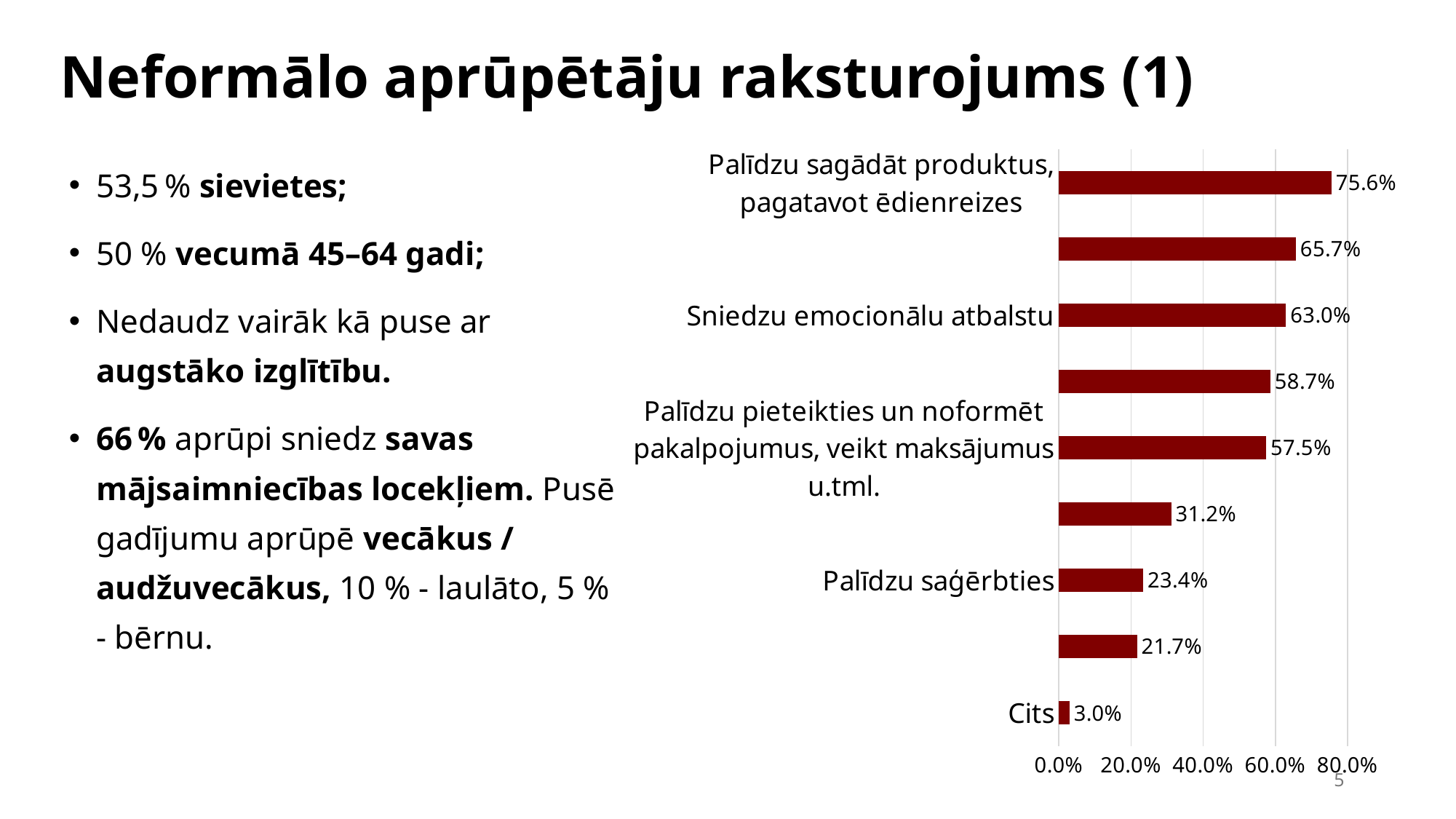
What is the value for "Palīdzu saģērbties"? 23.4% What is the value for "Palīdzu pieteikties un noformēt pakalpojumus, veikt maksājumus u.tml."? 57.5% Which category has the lowest value? Cits What is the difference between the values for "Sniedzu emocionālu atbalstu" and "Palīdzu saģērbties"? 39.6% What kind of chart is shown on the slide? bar chart Which is larger: the value for "Sniedzu emocionālu atbalstu" or the value for "Palīdzu pieteikties un noformēt pakalpojumus, veikt maksājumus u.tml."? Sniedzu emocionālu atbalstu What is the value for "Palīdzu sagādāt produktus, pagatavot ēdienreizes"? 75.6% What is the value for "Cits"? 3.0% How many bars are plotted in the chart? 9 Which category has the highest value? Palīdzu sagādāt produktus, pagatavot ēdienreizes Is the value for "Palīdzu saģērbties" greater or less than 40.0%? less What is the value for "Sniedzu emocionālu atbalstu"? 63.0%